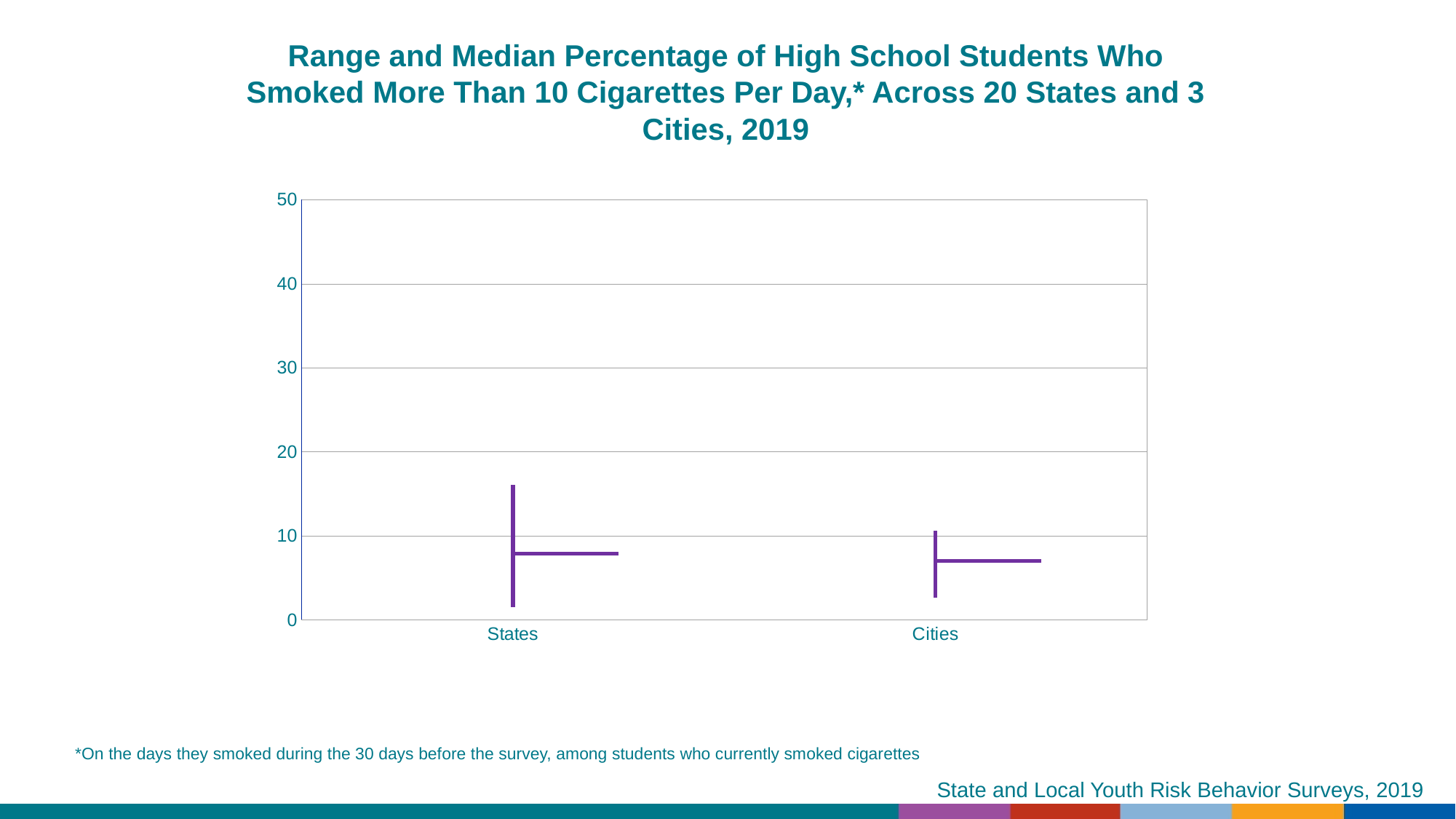
Is the bottom of the range for States greater or less than 10? less Which category shows the wider range of values? States Is the median value for Cities greater or less than 10? less Is the top of the range for States greater or less than 20? less What is the title of the chart? Range and Median Percentage of High School Students Who Smoked More Than 10 Cigarettes Per Day,* Across 20 States and 3 Cities, 2019 Which category has the higher top of its range, States or Cities? States What is the highest value shown on the y axis? 50 What are the two categories shown on the x axis? States and Cities How many categories are shown on the x axis of the chart? 2